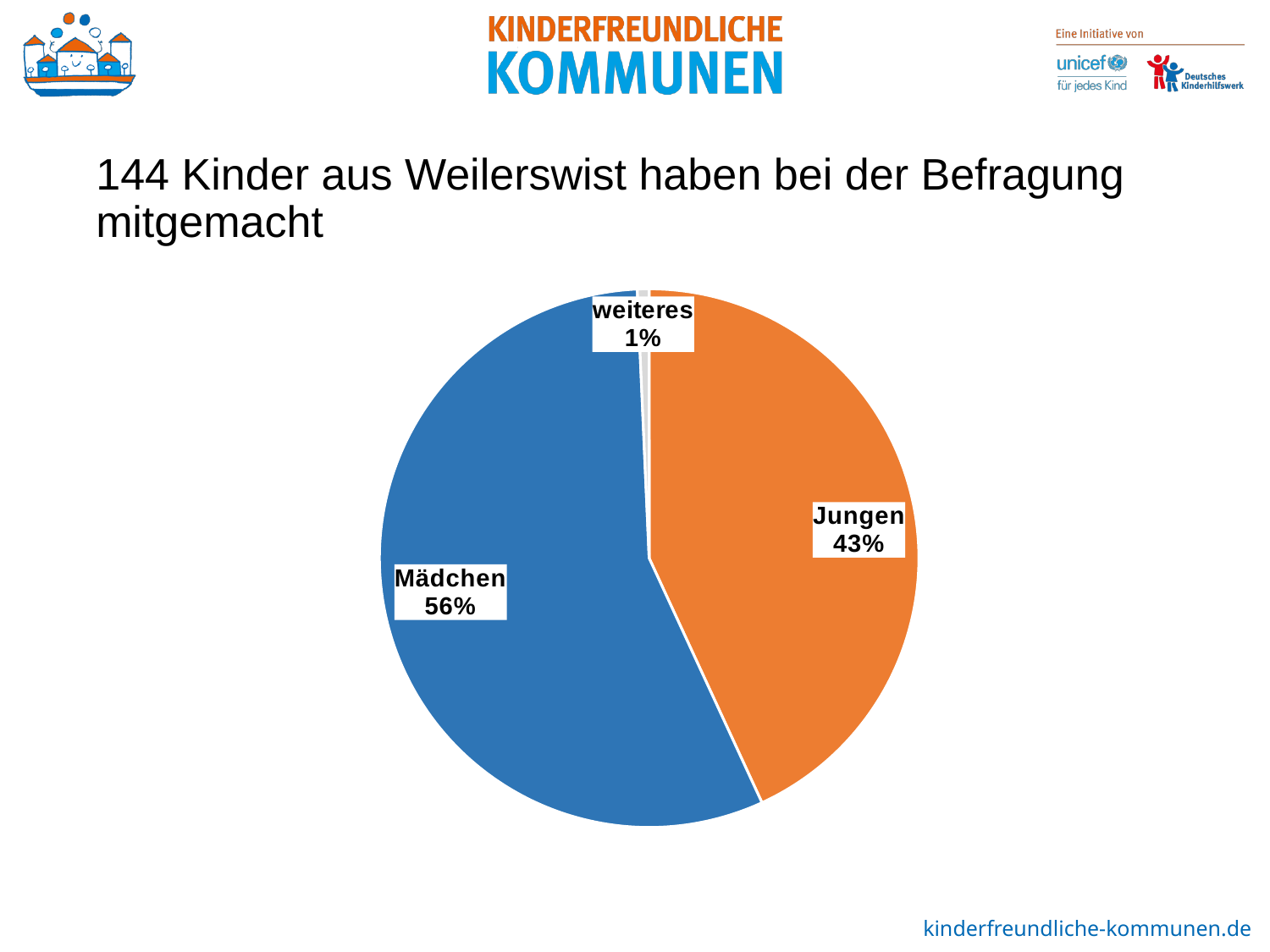
What colour is the Mädchen slice of the pie? blue Which category has the largest slice of the pie? Mädchen Which is larger, the share for Mädchen or the share for Jungen? Mädchen How many slices does the pie chart have? 3 What kind of chart is shown on the slide? pie chart What is the difference in percentage points between the Mädchen share and the Jungen share? 13 What share of the pie does Jungen have? 43% What share of the pie does weiteres have? 1% What colour is the Jungen slice of the pie? orange What share of the pie does Mädchen have? 56% Which category has the smallest slice of the pie? weiteres What is the difference in percentage points between the Jungen share and the weiteres share? 42